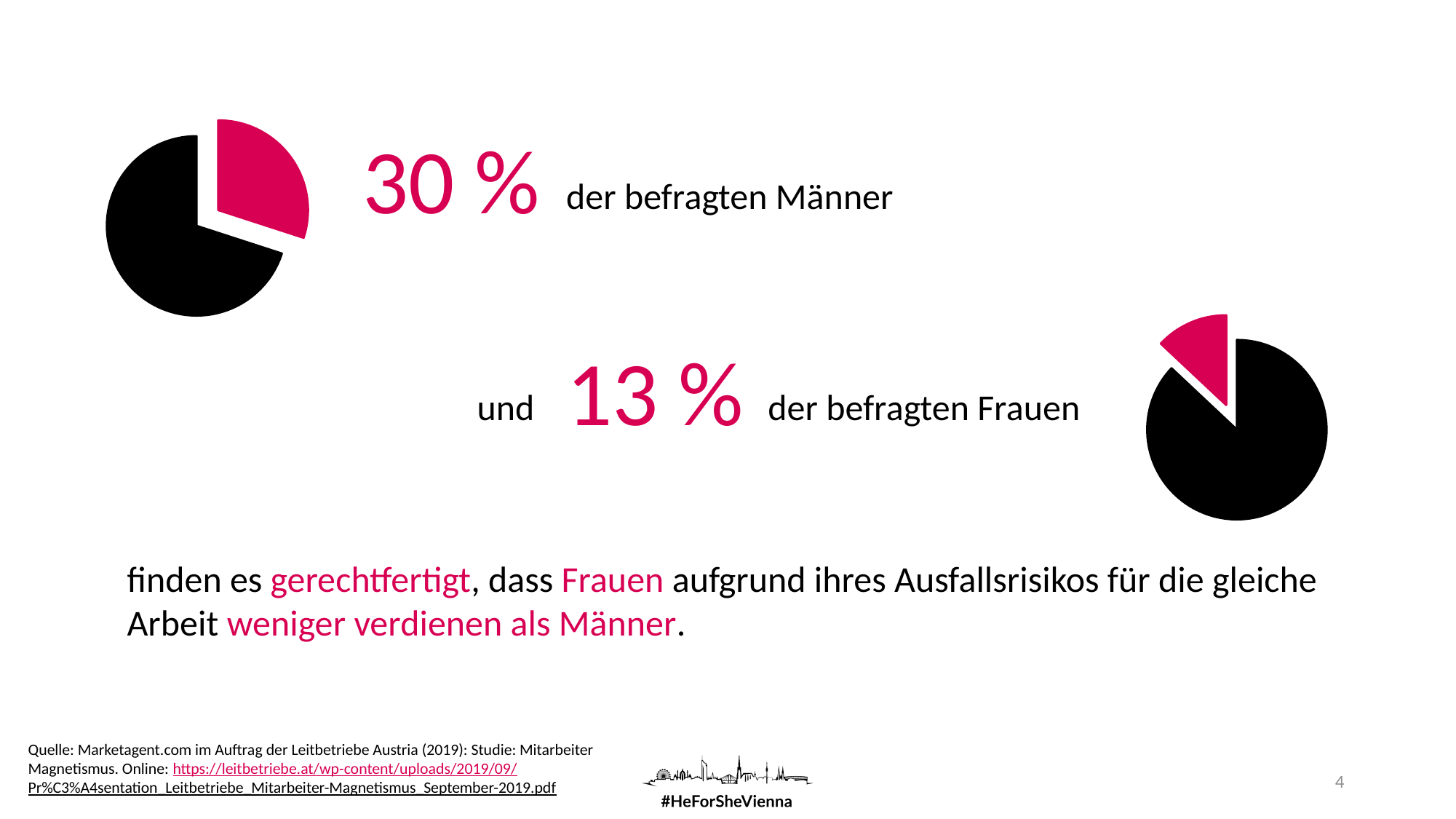
By how many percentage points does the men's share (30 %) exceed the women's share (13 %)? 17 % What colour is the highlighted slice in both pie charts? Pink (magenta) In the bottom-right pie chart, what percentage of the surveyed women (befragte Frauen) is highlighted? 13 % In the top-left pie chart, what percentage of the surveyed men (befragte Männer) is highlighted? 30 % How many slices does each pie chart on the slide have? 2 Which group has the smaller highlighted share in its pie chart? Frauen (women) What kind of chart is used on this slide to show the shares of surveyed men and women? Pie chart Which group has the larger highlighted share: the surveyed men or the surveyed women? Männer (men) Which group's pie chart is positioned on the right side of the slide? Befragte Frauen (surveyed women) How many pie charts are shown on the slide? 2